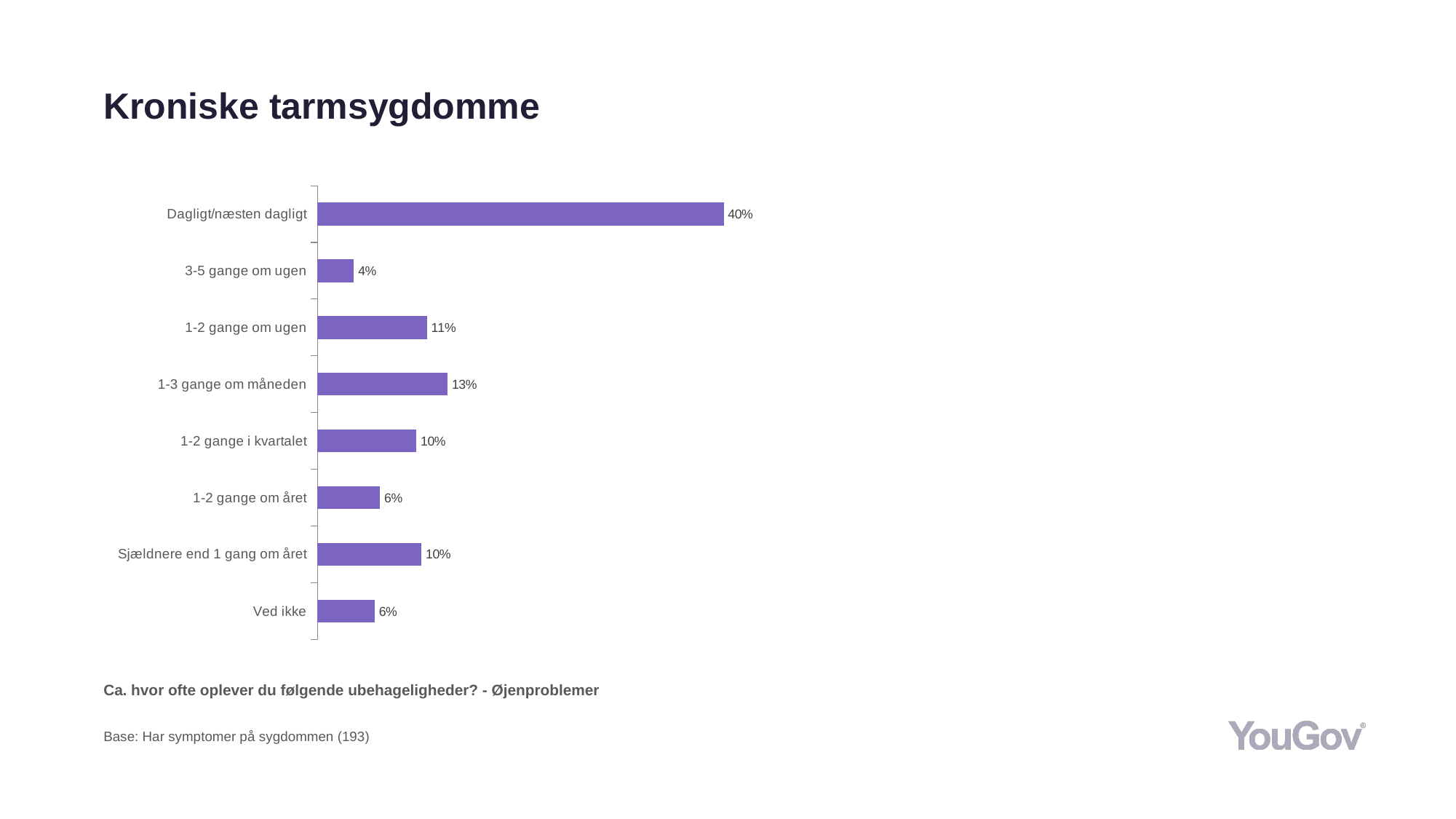
Which category has the lowest value? 3-5 gange om ugen What is the base size stated below the chart? 193 What is the value for "1-3 gange om måneden"? 13% What is the title of the slide? Kroniske tarmsygdomme What is the value for "Ved ikke"? 6% How many categories are shown in the chart? 8 Which category has the highest value? Dagligt/næsten dagligt What is the value for "Dagligt/næsten dagligt"? 40% What is the difference between "Dagligt/næsten dagligt" and "1-3 gange om måneden"? 27 percentage points What is the value for "3-5 gange om ugen"? 4% What kind of chart is shown on the slide? Bar chart Which is larger, "1-2 gange om ugen" or "1-2 gange om året"? 1-2 gange om ugen